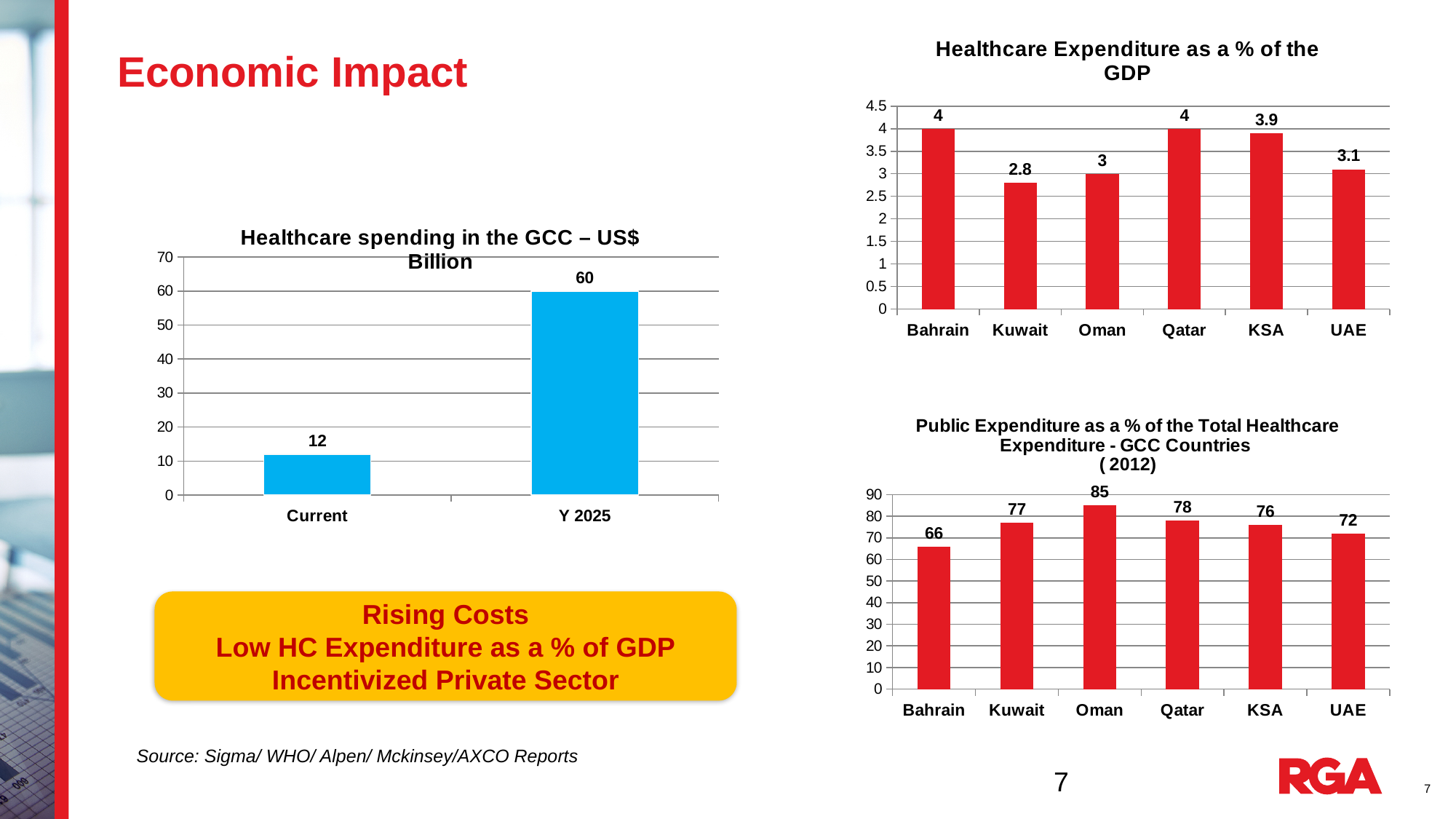
In the 'Healthcare Expenditure as a % of the GDP' chart, which country has the lowest value? Kuwait In the 'Healthcare Expenditure as a % of the GDP' chart, what is the value for Kuwait? 2.8 In the 'Healthcare spending in the GCC – US$ Billion' chart, what is the value for Y 2025? 60 In the 'Healthcare spending in the GCC – US$ Billion' chart, what is the difference between the Y 2025 and Current values? 48 In the 'Public Expenditure as a % of the Total Healthcare Expenditure - GCC Countries (2012)' chart, what is the value for Bahrain? 66 What type of chart is the 'Healthcare Expenditure as a % of the GDP' chart? Bar chart In the 'Healthcare Expenditure as a % of the GDP' chart, which is larger, KSA or UAE? KSA In the 'Public Expenditure as a % of the Total Healthcare Expenditure - GCC Countries (2012)' chart, what is the difference between Oman and UAE? 13 In the 'Public Expenditure as a % of the Total Healthcare Expenditure - GCC Countries (2012)' chart, which country has the highest value? Oman In the 'Healthcare spending in the GCC – US$ Billion' chart, how many categories are shown? 2 In the 'Healthcare Expenditure as a % of the GDP' chart, what is the difference between Bahrain and Oman? 1 In the 'Public Expenditure as a % of the Total Healthcare Expenditure - GCC Countries (2012)' chart, how many countries are shown? 6